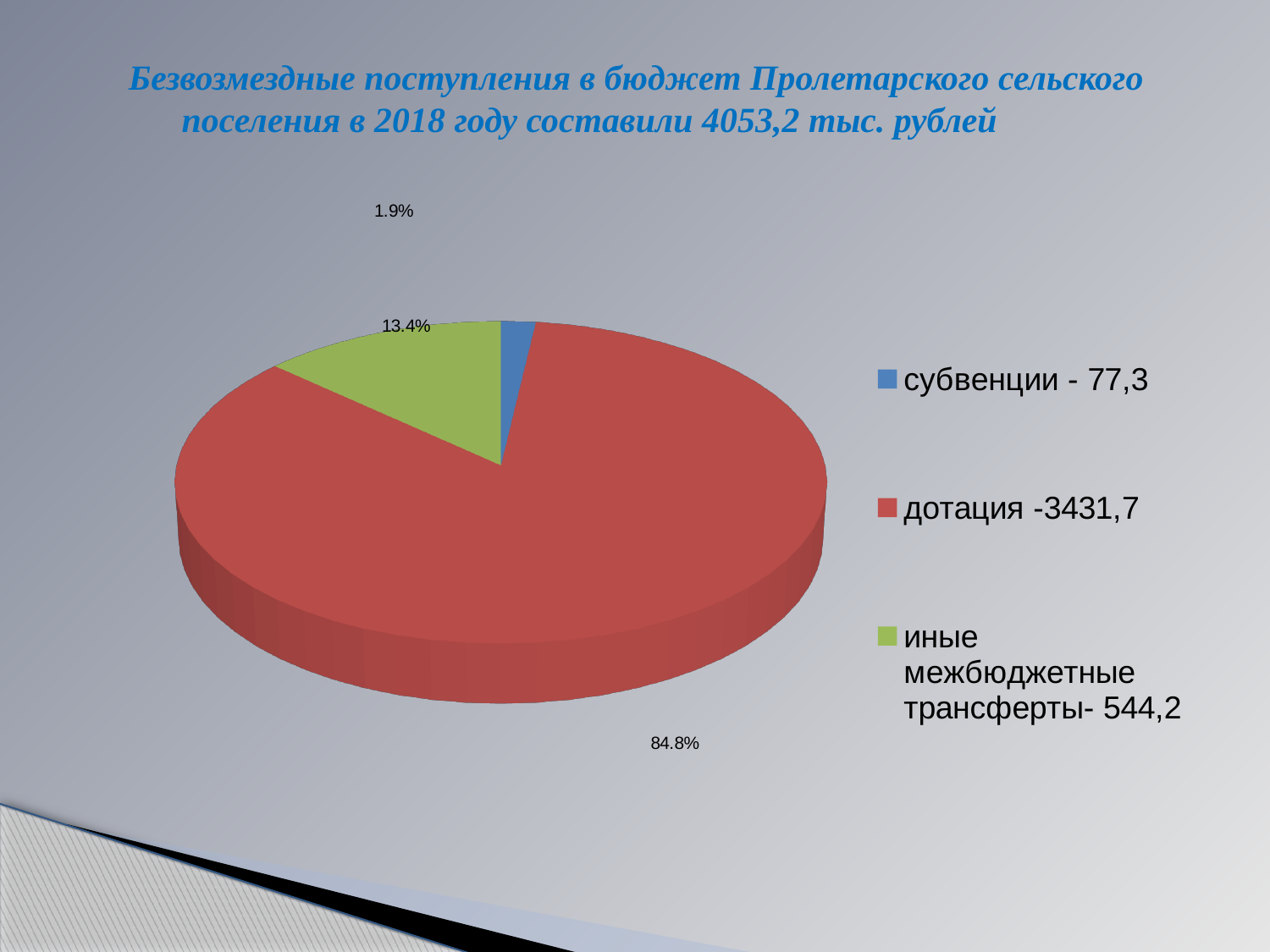
What value is given for субвенции in the legend? 77,3 Which category has the smallest slice of the pie? субвенции Which is larger, the value for иные межбюджетные трансферты or the value for субвенции? иные межбюджетные трансферты Which category has the largest slice of the pie? дотация How many entries does the legend list? 3 What kind of chart is shown on the slide? pie chart What share of the pie does the дотация slice represent? 84.8% What share of the pie does the иные межбюджетные трансферты slice represent? 13.4% What is the difference between the values for дотация and иные межбюджетные трансферты shown in the legend? 2887,5 What share of the pie does the субвенции slice represent? 1.9% How many slices does the pie chart have? 3 What value is given for дотация in the legend? 3431,7